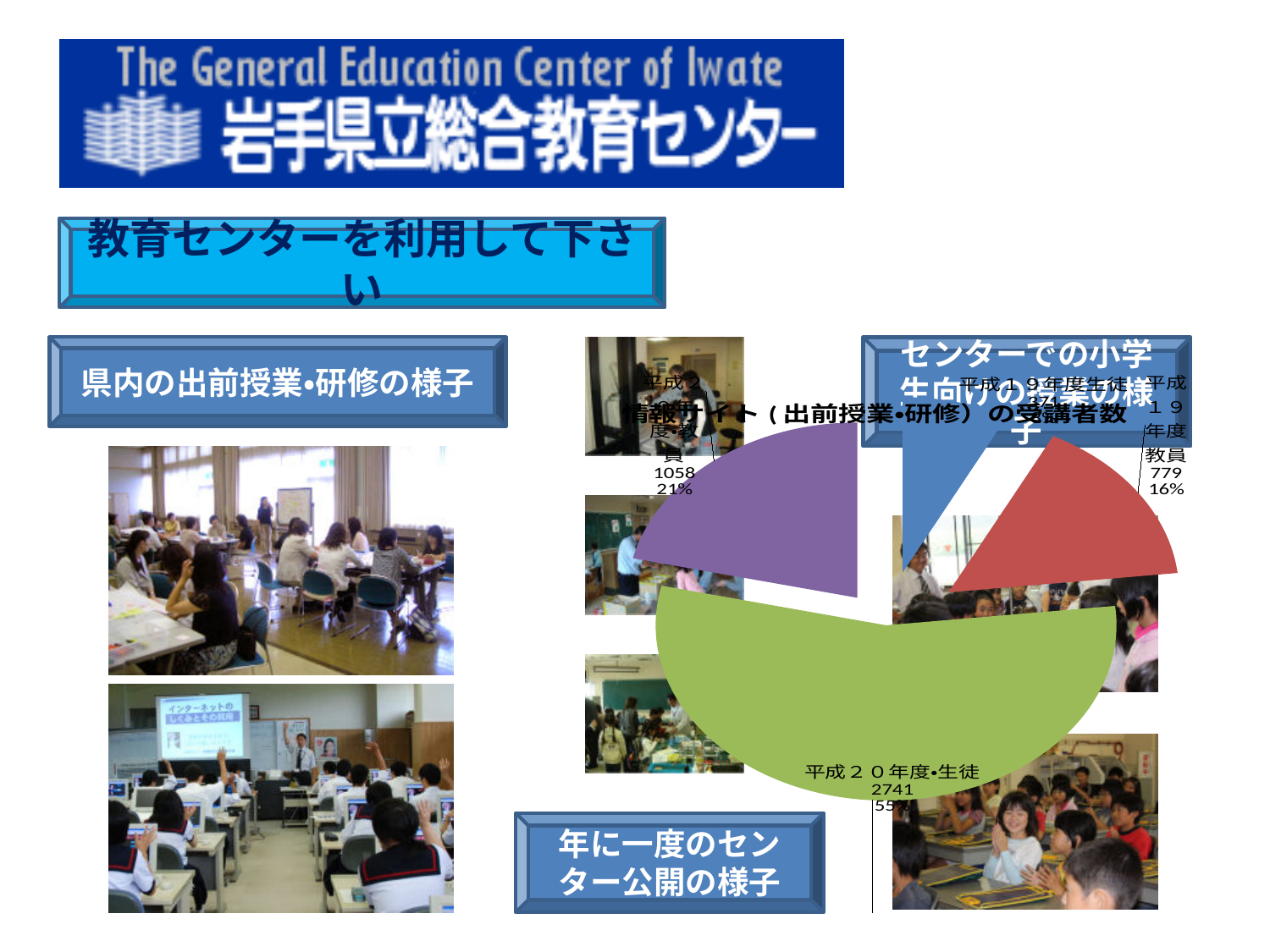
What is the value shown for 平成１９年度教員 in the pie chart? 779 Which is larger, the value for 平成２０年度•教員 or the value for 平成１９年度教員? 平成２０年度•教員 What share of the pie does 平成１９年度教員 represent? 16% What is the value shown for 平成２０年度•教員 in the pie chart? 1058 Which category has the largest slice in the pie chart? 平成２０年度•生徒 What is the difference between the values for 平成２０年度•生徒 and 平成２０年度•教員? 1683 What kind of chart is shown on the slide? pie chart What colour is the largest slice of the pie chart? green What share of the pie does 平成２０年度•教員 represent? 21% What share of the pie does 平成２０年度•生徒 represent? 55% What is the value shown for 平成２０年度•生徒 in the pie chart? 2741 How many slices does the pie chart have? 4